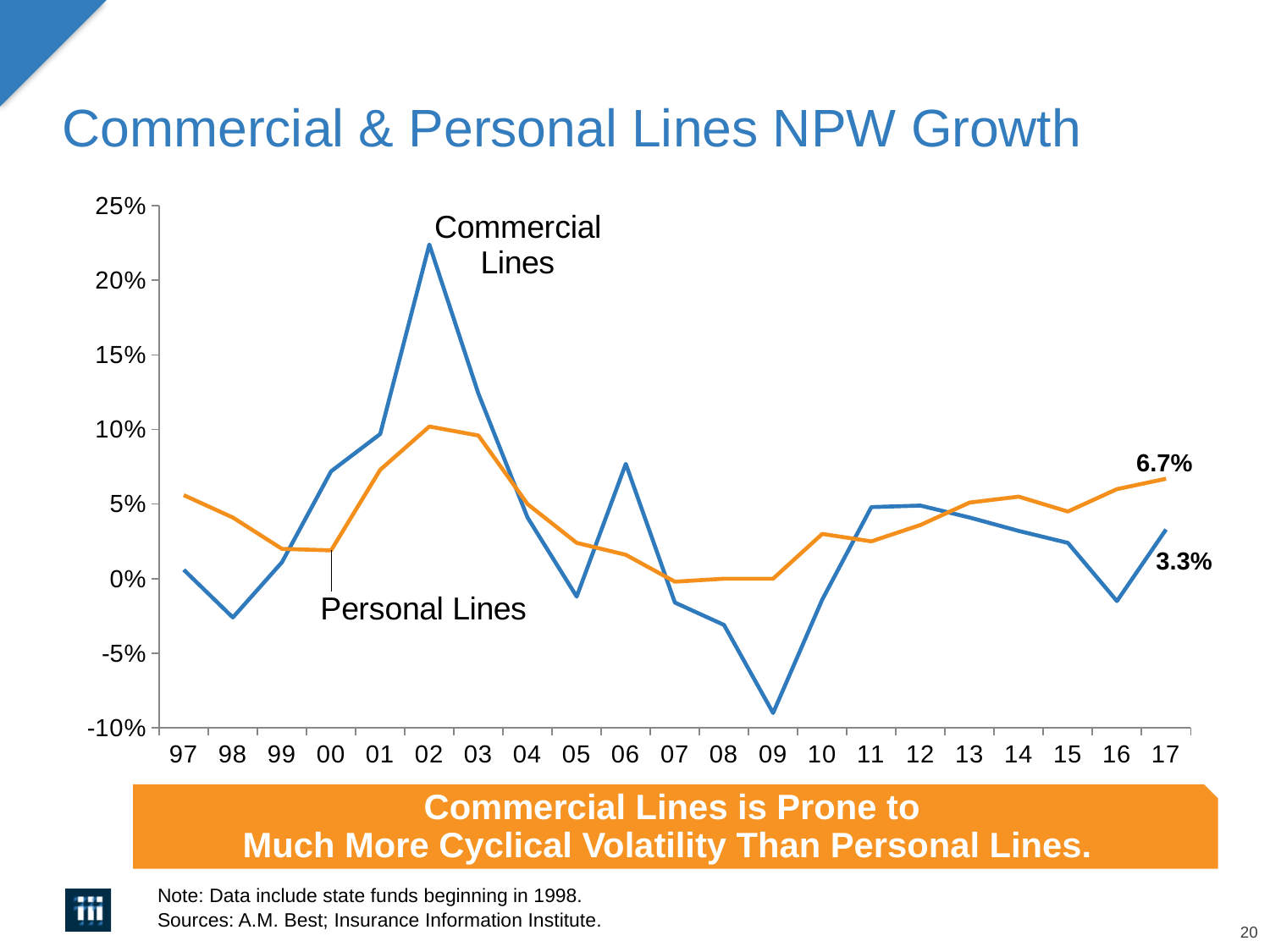
How many years are shown on the x axis of the chart? 21 In which year does the Commercial Lines series reach its lowest value? 09 What kind of chart is shown on the slide? Line chart In which year does the Commercial Lines series reach its highest value? 02 In 17, which series has the higher NPW growth, Commercial Lines or Personal Lines? Personal Lines What is the difference between the Personal Lines and Commercial Lines values labeled for 17? 3.4 percentage points Is the Commercial Lines value for 02 greater or less than 20%? greater What is the title of the chart on the slide? Commercial & Personal Lines NPW Growth How many data series are plotted on the chart? 2 What is the Commercial Lines NPW growth value labeled for 17? 3.3% What is the Personal Lines NPW growth value labeled for 17? 6.7% Is the Commercial Lines value for 09 greater or less than -5%? less